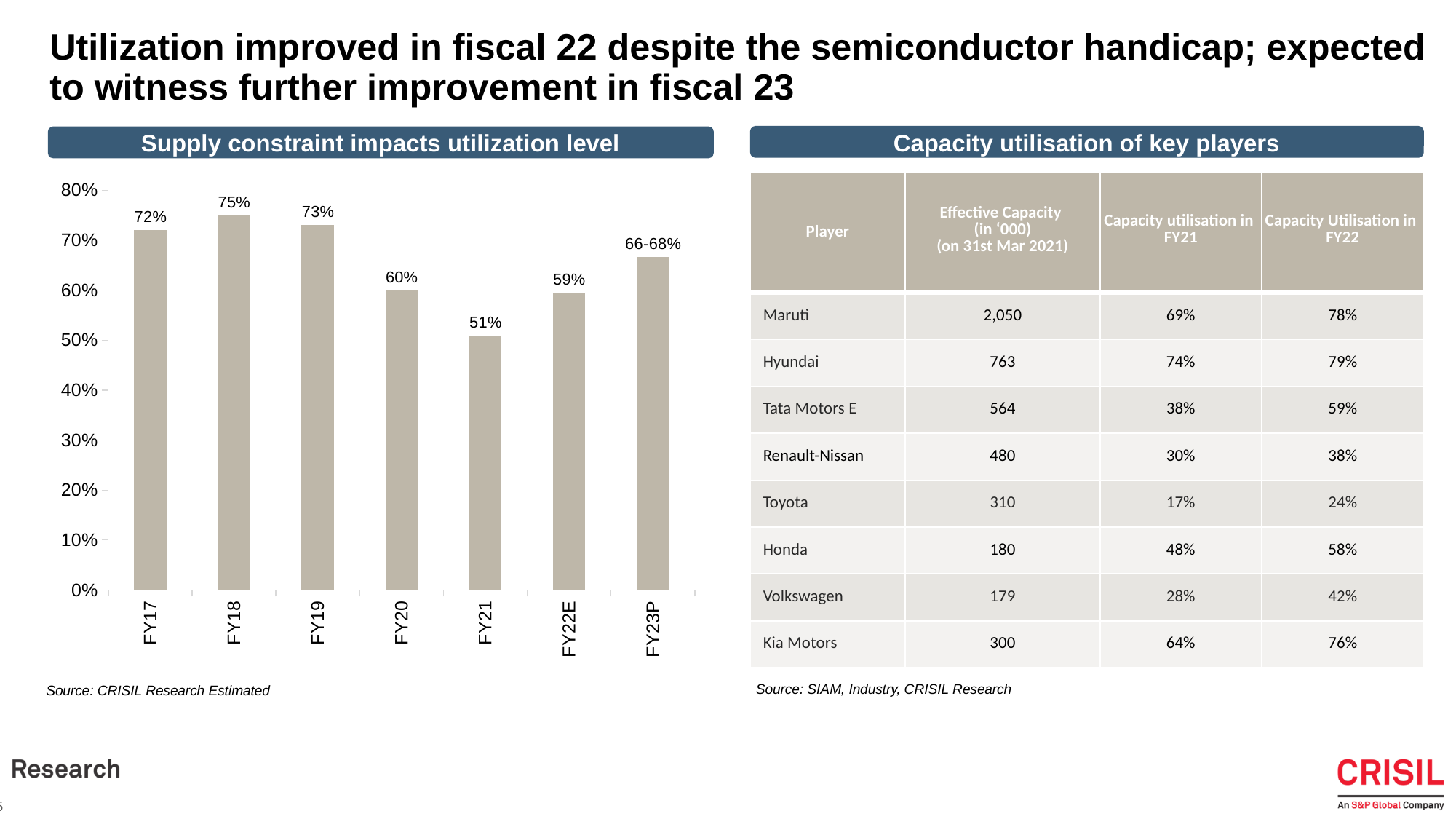
Which is higher, the utilization level for FY19 or for FY22E? FY19 Which fiscal year has the highest utilization level in the chart? FY18 What utilization level is shown for FY23P? 66-68% What kind of chart is used to show the utilization levels? Bar chart By how many percentage points does the FY18 utilization level exceed the FY20 level? 15 percentage points By how many percentage points does the FY17 utilization level exceed the FY21 level? 21 percentage points Which fiscal year has the lowest utilization level in the chart? FY21 Is the utilization level for FY20 greater or less than 50%? greater What is the utilization level shown for FY21? 51% What is the utilization level shown for FY17? 72% How many fiscal years are plotted in the chart? 7 Does the utilization level rise or fall from FY18 to FY21? Fall